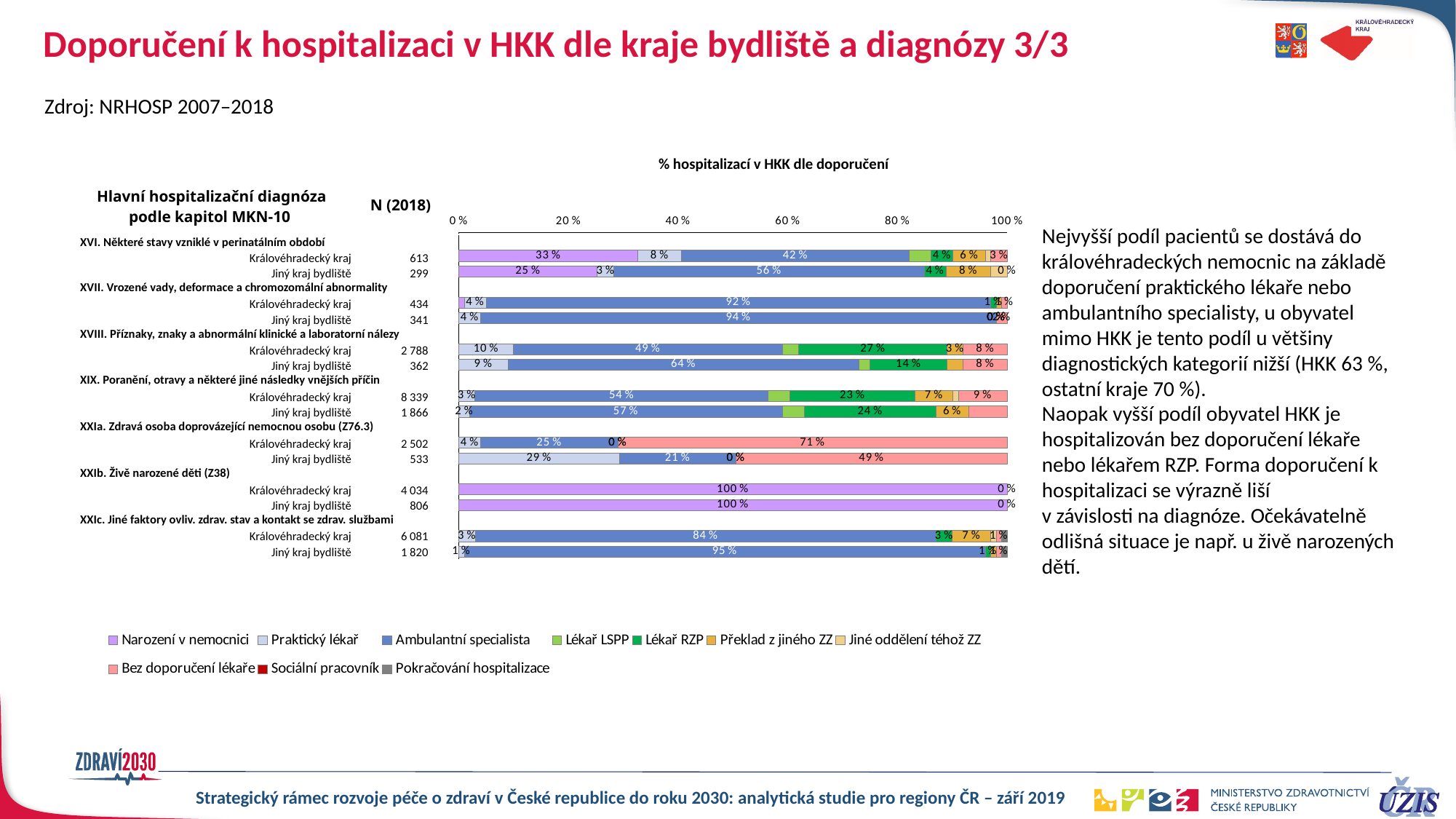
What kind of chart is shown on the slide? stacked bar chart What is the share of 'Lékař RZP' for Královéhradecký kraj in chapter XVIII. Příznaky, znaky a abnormální klinické a laboratorní nálezy? 27 % In chapter XIX. Poranění, otravy a některé jiné následky vnějších příčin, which has the larger 'Ambulantní specialista' share: Královéhradecký kraj or Jiný kraj bydliště? Jiný kraj bydliště What is the share of 'Narození v nemocnici' for Královéhradecký kraj in chapter XXIb. Živě narozené děti (Z38)? 100 % What is the difference between the 'Bez doporučení lékaře' shares of Královéhradecký kraj and Jiný kraj bydliště in chapter XXIa. Zdravá osoba doprovázející nemocnou osobu (Z76.3)? 22 % What is the share of 'Narození v nemocnici' for Jiný kraj bydliště in chapter XVI. Některé stavy vzniklé v perinatálním období? 25 % What is the N (2018) value for Královéhradecký kraj in chapter XIX. Poranění, otravy a některé jiné následky vnějších příčin? 8 339 What is the title of the chart? % hospitalizací v HKK dle doporučení How many bars (region rows) are plotted in the chart? 14 What is the share of 'Ambulantní specialista' for Královéhradecký kraj in chapter XVII. Vrozené vady, deformace a chromozomální abnormality? 92 % How many series does the chart legend list? 10 What is the share of 'Bez doporučení lékaře' for Královéhradecký kraj in chapter XXIa. Zdravá osoba doprovázející nemocnou osobu (Z76.3)? 71 %